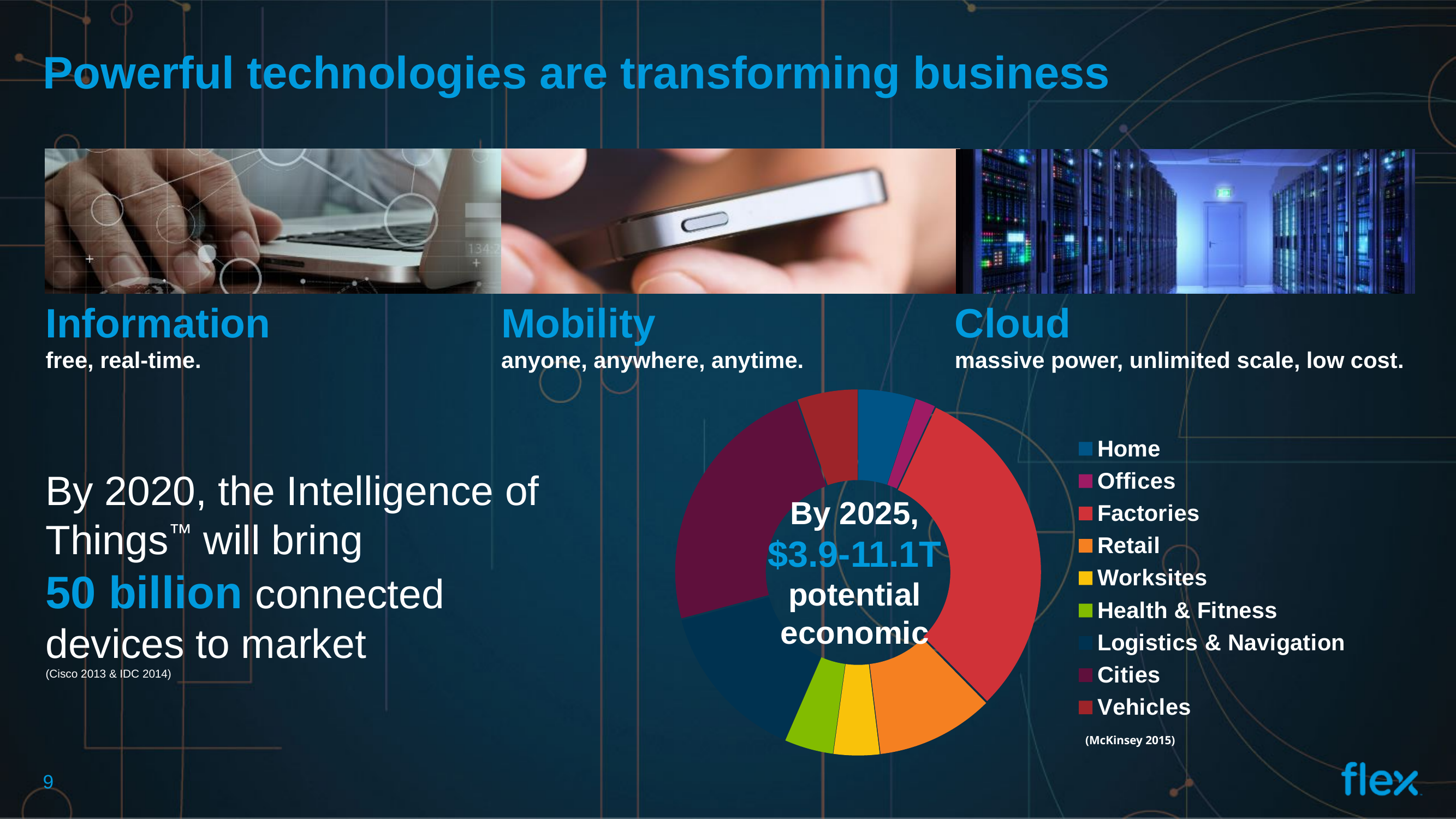
Which slice is larger in the doughnut chart, Cities or Health & Fitness? Cities What potential economic value range is printed in the centre of the doughnut chart? $3.9-11.1T Which category has the smallest slice in the doughnut chart? Offices Which slice is larger in the doughnut chart, Home or Offices? Home Which slice is larger in the doughnut chart, Factories or Cities? Factories What source is cited below the doughnut chart's legend? McKinsey 2015 What kind of chart is shown on the slide? Doughnut (pie) chart Which category has the largest slice in the doughnut chart? Factories How many categories does the doughnut chart's legend list? 9